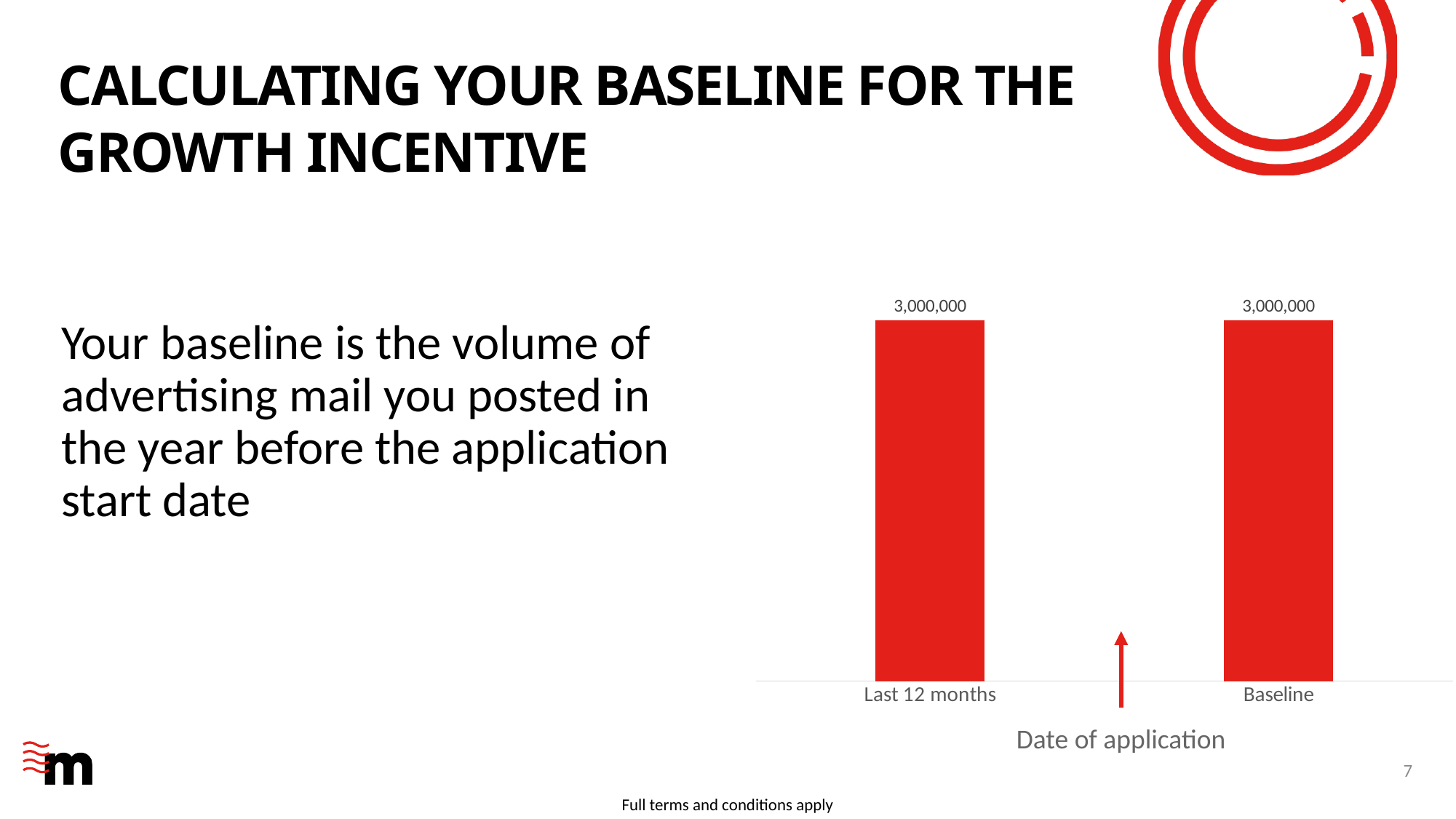
What is the value for Baseline? 3,000,000 What is the label of the first bar on the left? Last 12 months What is the difference between the Last 12 months value and the Baseline value? 0 What kind of chart is shown on the slide? bar chart What is the value for Last 12 months? 3,000,000 What is the total of the two bars in the chart? 6,000,000 What colour are the bars in the chart? Red How many bars are plotted in the chart? 2 Are the values for Last 12 months and Baseline equal? Yes What label appears under the arrow between the two bars? Date of application